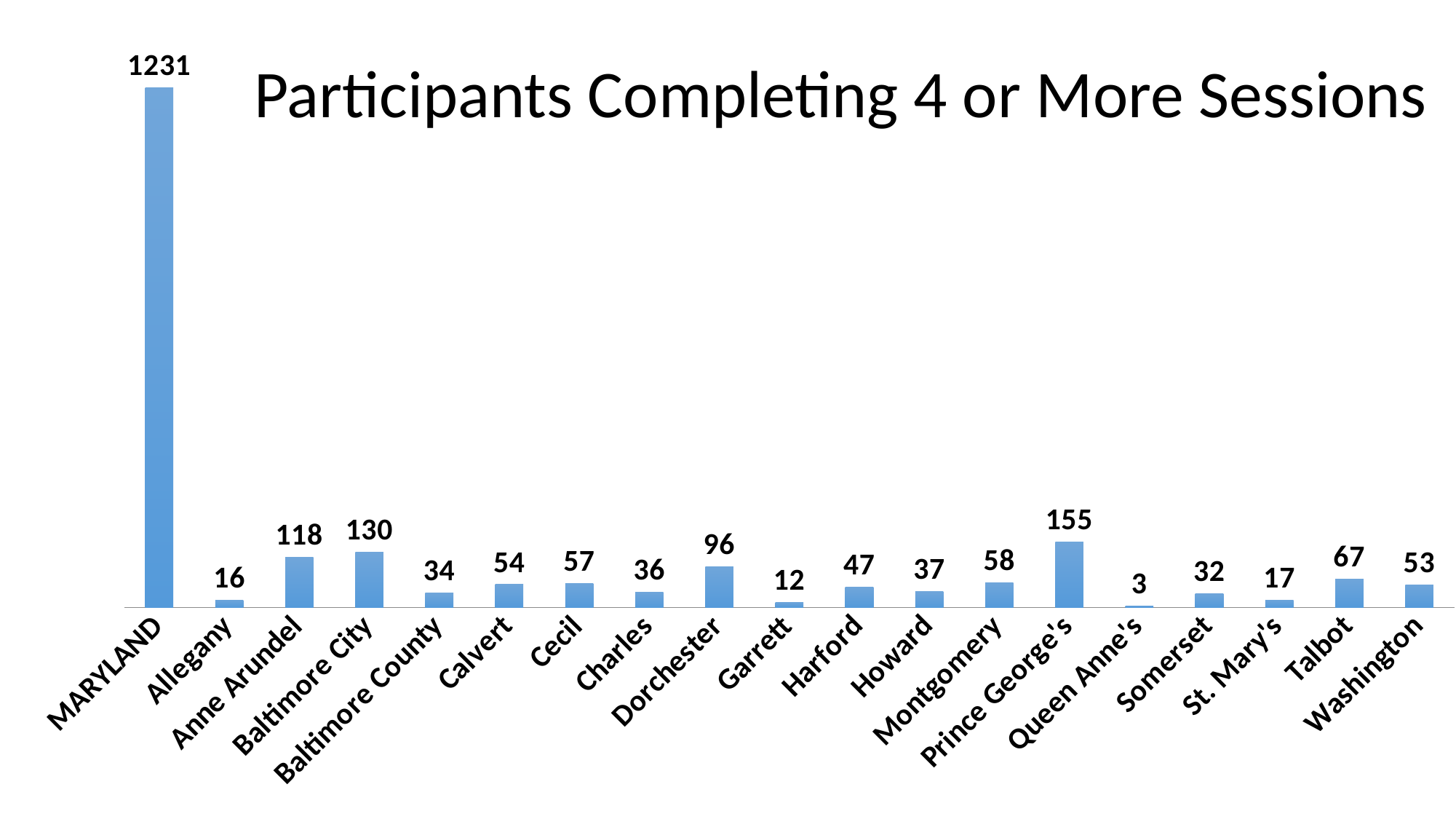
Which is larger, the value for Dorchester or the value for Talbot? Dorchester How many categories are shown on the x axis? 19 What is the value for Queen Anne's? 3 Which category has the highest value? MARYLAND What is the value for MARYLAND? 1231 What is the value for Baltimore City? 130 What is the title of the chart? Participants Completing 4 or More Sessions What is the difference between the values for Baltimore City and Anne Arundel? 12 Which category has the lowest value? Queen Anne's What kind of chart is this? Bar chart What is the difference between the values for Prince George's and Montgomery? 97 What is the value for Prince George's? 155